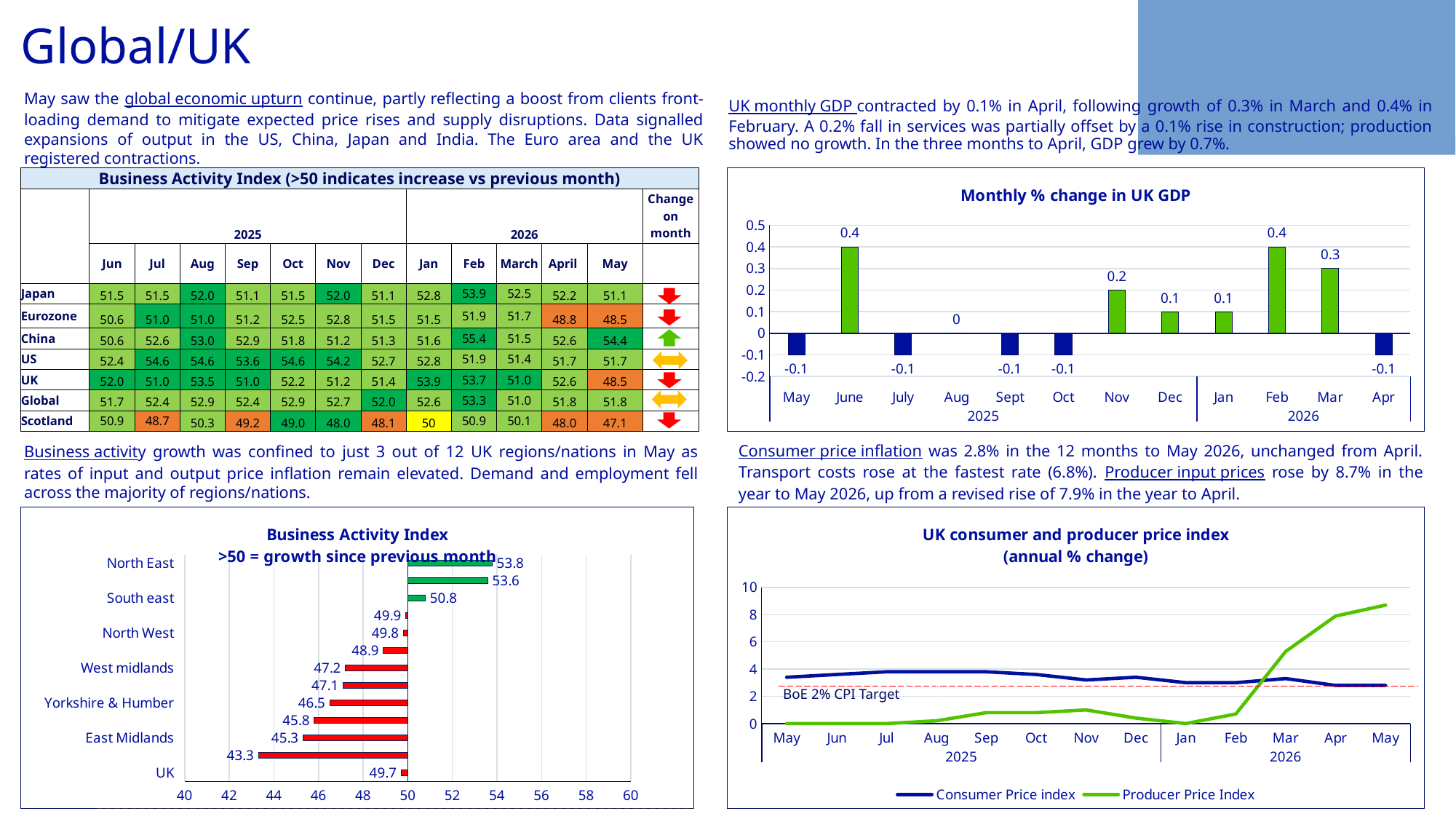
On the 'Business Activity Index >50 = growth since previous month' chart, what is the lowest value shown? 43.3 What kind of chart is 'Monthly % change in UK GDP'? Bar chart On the 'Monthly % change in UK GDP' chart, which is larger, the value for Nov 2025 or Dec 2025? Nov 2025 On the 'UK consumer and producer price index (annual % change)' chart, is the Producer Price Index value for May 2026 greater or less than 8? greater On the 'Monthly % change in UK GDP' chart, what is the difference between the Mar 2026 and Apr 2026 values? 0.4 How many monthly bars are plotted on the 'Monthly % change in UK GDP' chart? 12 On the 'Business Activity Index >50 = growth since previous month' chart, what is the highest value shown? 53.8 How many series does the legend list on the 'UK consumer and producer price index (annual % change)' chart? 2 On the 'Monthly % change in UK GDP' chart, what is the value for Apr 2026? -0.1 How many bars are plotted on the 'Business Activity Index >50 = growth since previous month' chart? 13 On the 'Monthly % change in UK GDP' chart, what is the value for June 2025? 0.4 On the 'UK consumer and producer price index (annual % change)' chart, what does the red dashed horizontal line represent? BoE 2% CPI Target